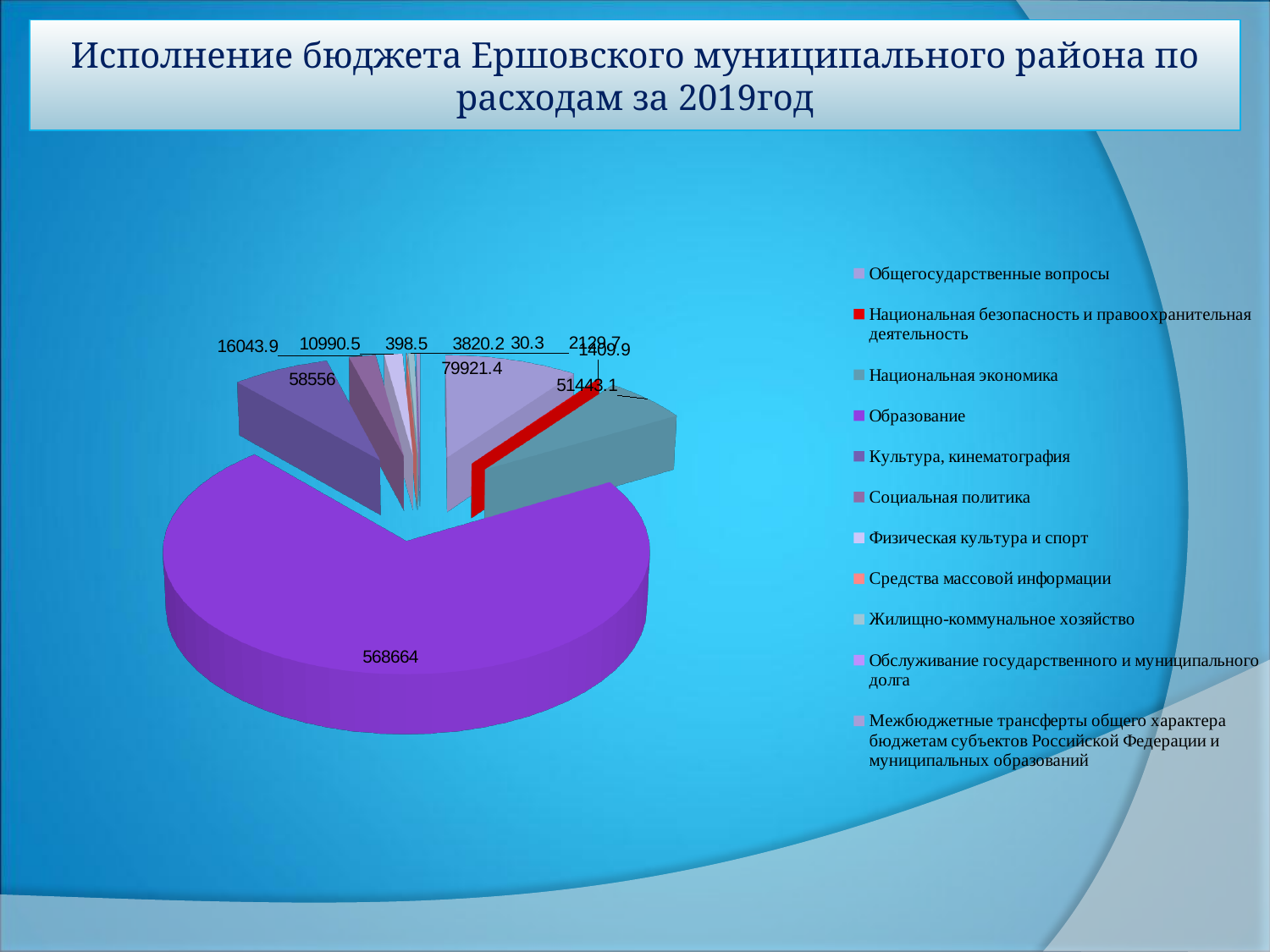
What is the value labelled on the largest slice of the pie chart? 568664 What is the difference between the slices labelled 58556 and 51443.1? 7112.9 Is the value for Образование greater or less than 500000? greater How many categories does the legend of the pie chart list? 11 Which category has the largest slice of the pie chart? Образование Which is larger in the pie chart: the slice labelled 79921.4 or the slice labelled 51443.1? 79921.4 What is the smallest value labelled on the pie chart? 30.3 Which legend entry is shown in red in the pie chart? Национальная безопасность и правоохранительная деятельность What is the difference between the slice labelled 568664 and the slice labelled 79921.4? 488742.6 What kind of chart is shown on the slide? pie chart What is the value for Образование in the pie chart? 568664 What is the title of the slide's chart? Исполнение бюджета Ершовского муниципального района по расходам за 2019год